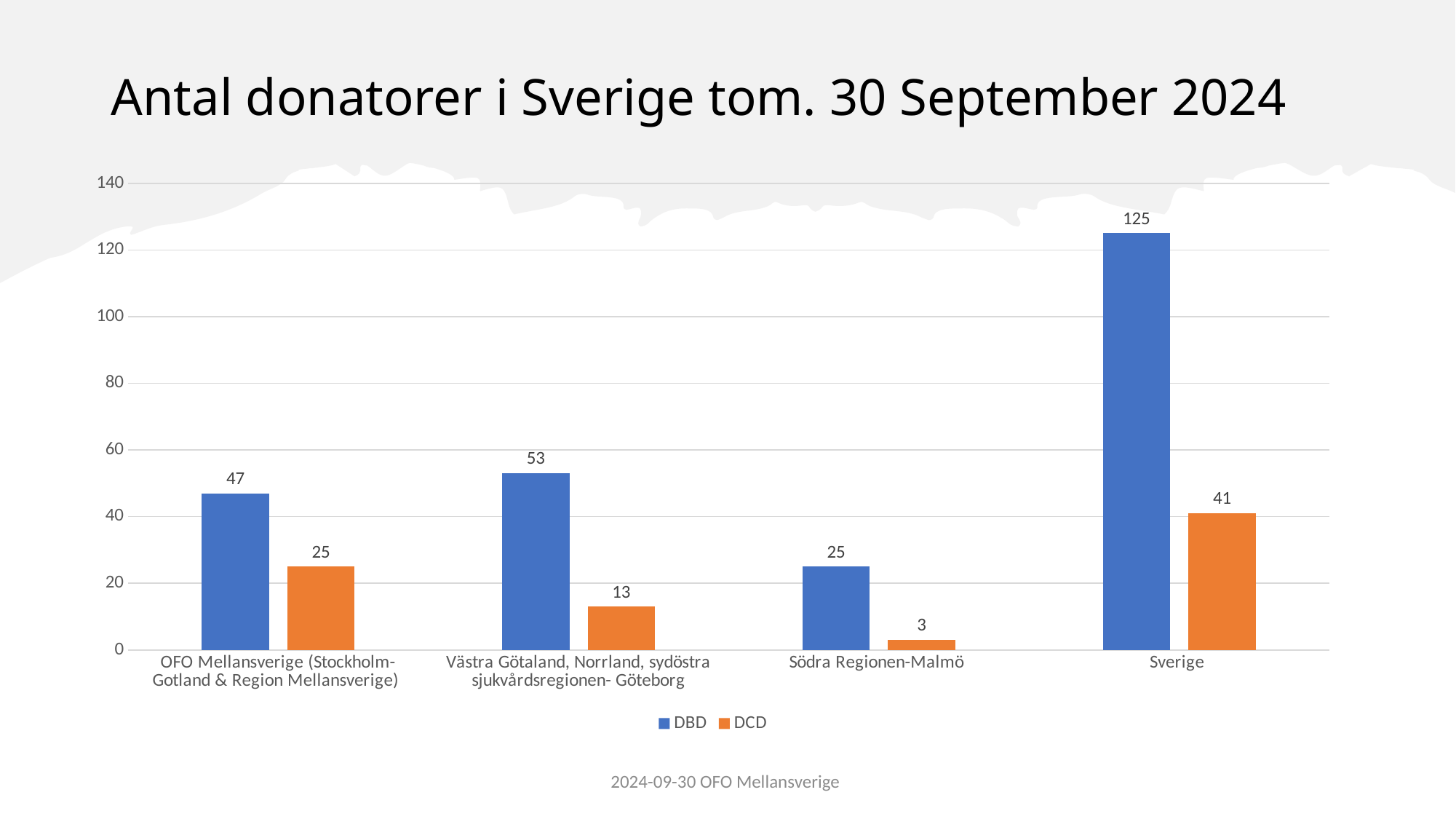
What is the DCD value for Södra Regionen-Malmö? 3 Is the DBD value for Sverige greater or less than 120? greater Which category has the highest DCD value? Sverige What is the DCD value for OFO Mellansverige (Stockholm-Gotland & Region Mellansverige)? 25 What is the difference between the DBD and DCD values for Sverige? 84 Which is larger, the DBD value for OFO Mellansverige or the DBD value for Västra Götaland, Norrland, sydöstra sjukvårdsregionen- Göteborg? Västra Götaland, Norrland, sydöstra sjukvårdsregionen- Göteborg What is the DBD value for Västra Götaland, Norrland, sydöstra sjukvårdsregionen- Göteborg? 53 Which category has the lowest DBD value? Södra Regionen-Malmö How many categories are shown on the x axis? 4 What kind of chart is shown on the slide? Bar chart What is the DBD value for Sverige? 125 How many series does the legend list? 2